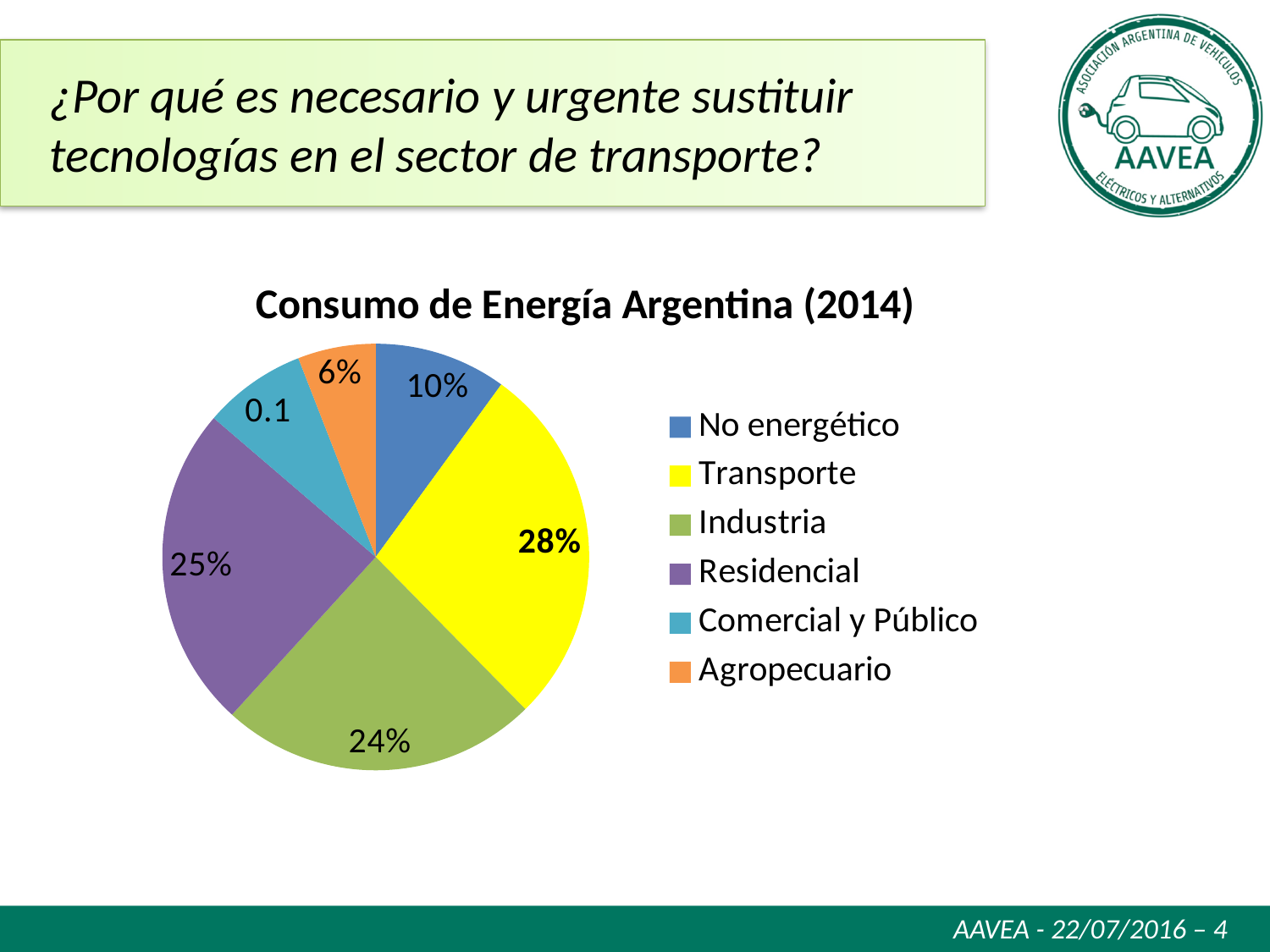
What is the value shown for Industria? 24% What is the value shown for Agropecuario? 6% What is the value shown for Residencial? 25% What colour is the Transporte slice? yellow Which is larger, the share for Residencial or the share for Industria? Residencial What is the value shown for No energético? 10% Which sector has the largest share of the pie? Transporte What kind of chart is shown on the slide? pie chart How many sectors are listed in the legend? 6 What is the difference between the Transporte share and the Industria share? 4% What share of energy consumption does Transporte account for? 28% What is the title of the chart? Consumo de Energía Argentina (2014)